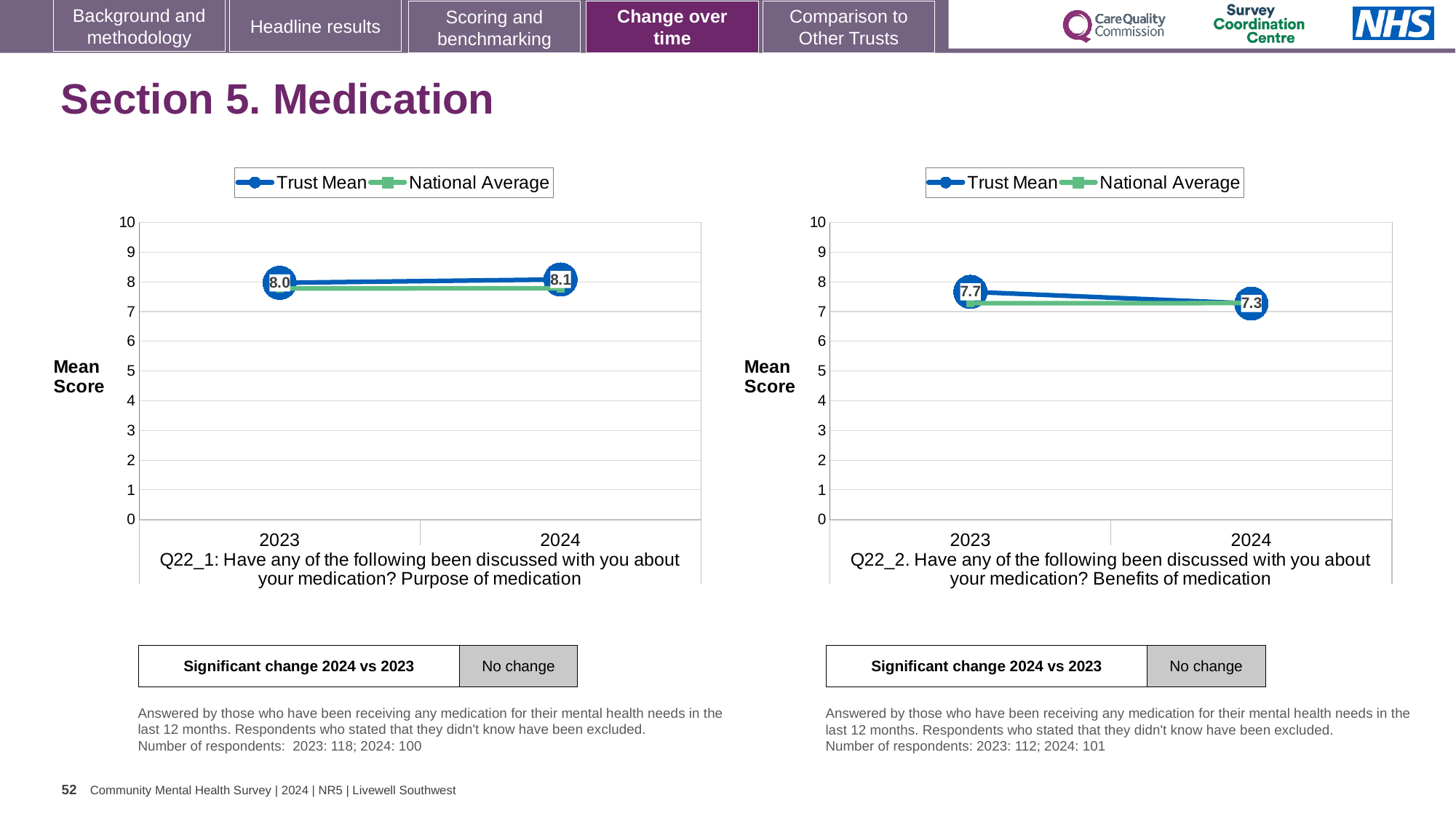
In the right chart (Q22_2: Benefits of medication), what is the Trust Mean for 2024? 7.3 In the left chart (Q22_1: Purpose of medication), what is the Trust Mean for 2023? 8.0 In the left chart (Q22_1: Purpose of medication), what is the Trust Mean for 2024? 8.1 In the left chart (Q22_1: Purpose of medication), does the Trust Mean rise or fall from 2023 to 2024? rise How many series does the legend of the left chart (Q22_1: Purpose of medication) list? 2 What kind of chart is the right chart (Q22_2: Benefits of medication)? line chart In the right chart (Q22_2: Benefits of medication), by how much did the Trust Mean change from 2023 to 2024? 0.4 In the right chart (Q22_2: Benefits of medication), does the Trust Mean rise or fall from 2023 to 2024? fall In the left chart (Q22_1: Purpose of medication), is the National Average for 2024 greater or less than 7? greater In the right chart (Q22_2: Benefits of medication), what is the Trust Mean for 2023? 7.7 In the right chart (Q22_2: Benefits of medication), which is larger in 2023, the Trust Mean or the National Average? Trust Mean In the left chart (Q22_1: Purpose of medication), what is the difference between the Trust Mean in 2024 and in 2023? 0.1